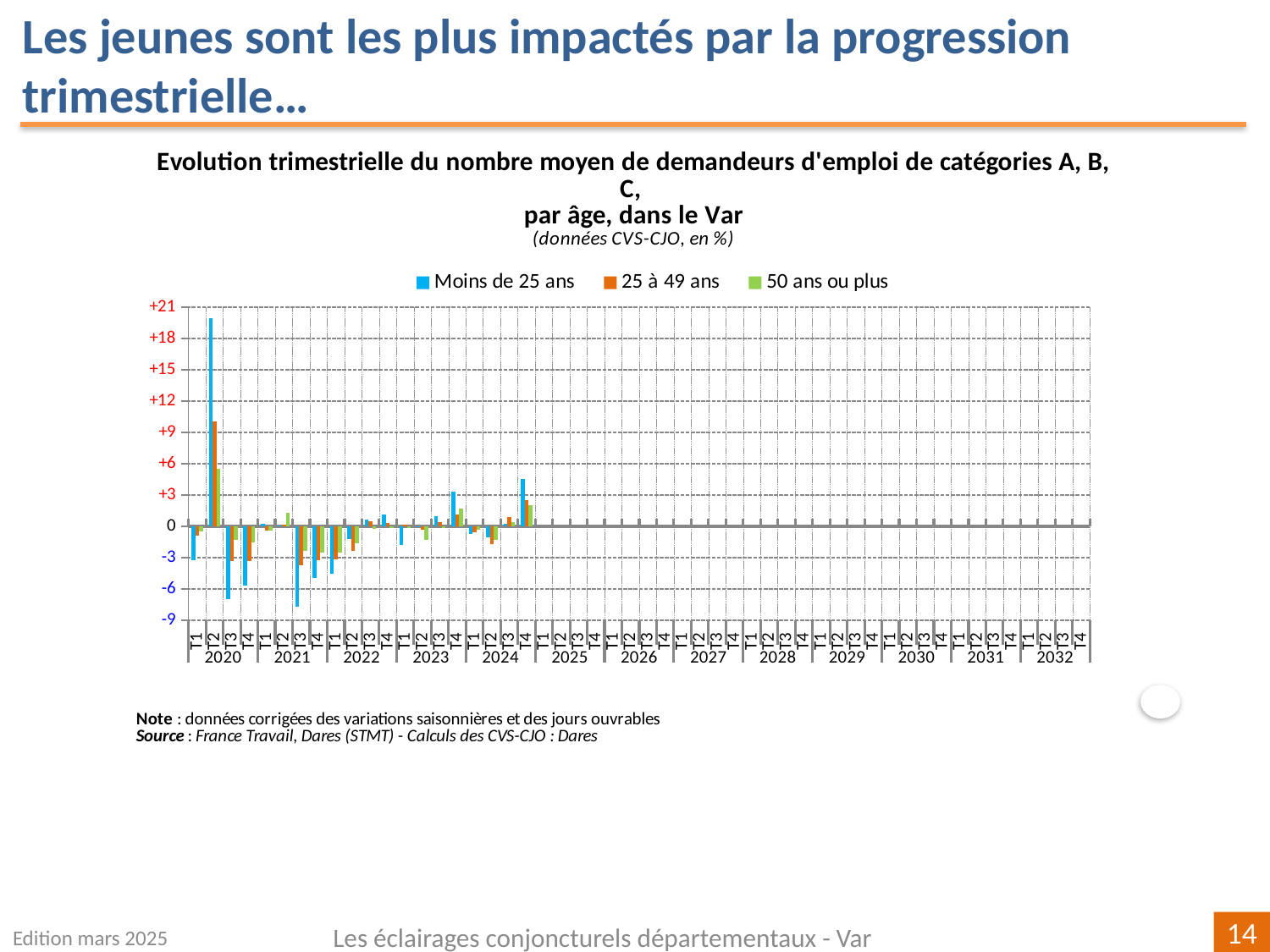
In which quarter does the Moins de 25 ans series reach its highest value? T2 2020 What kind of chart is shown on the slide? bar chart Which series has the highest bar in the whole chart? Moins de 25 ans Which colour represents the 25 à 49 ans series? orange How many years are labelled along the x axis? 13 Is the value for Moins de 25 ans in T1 2021 greater or less than -6? greater Is the value for Moins de 25 ans in T2 2020 greater or less than +18? greater Is the value for Moins de 25 ans in T4 2024 greater or less than +3? greater In T2 2020, which is larger: the value for Moins de 25 ans or the value for 25 à 49 ans? Moins de 25 ans How many series does the legend list? 3